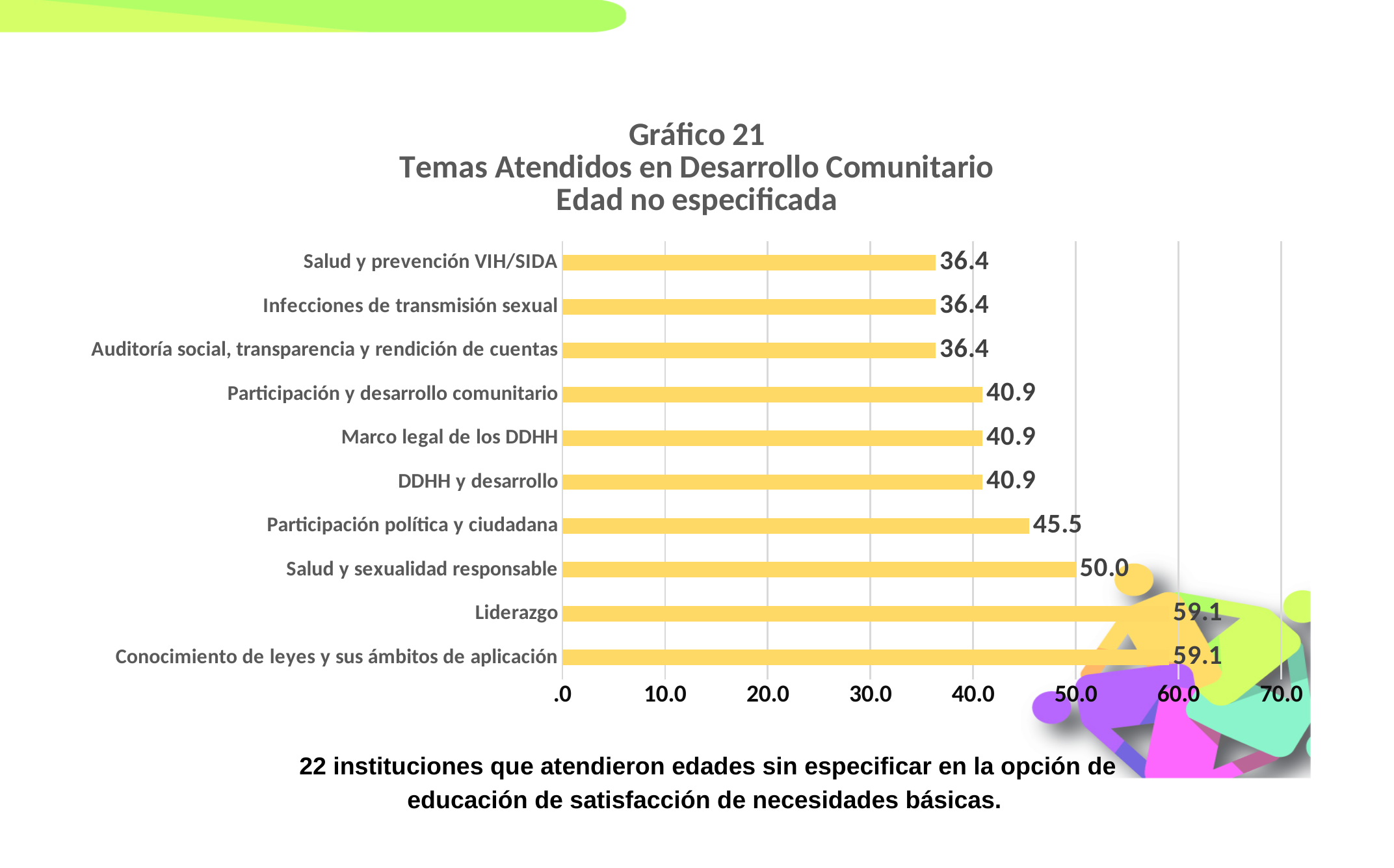
What is the value for Participación política y ciudadana? 45.5 How many categories are shown in the chart? 10 What kind of chart is shown on the slide? bar chart What is the title of the chart? Gráfico 21 Temas Atendidos en Desarrollo Comunitario Edad no especificada What is the value for Salud y prevención VIH/SIDA? 36.4 What is the value for Marco legal de los DDHH? 40.9 Is the value for Salud y sexualidad responsable greater or less than 40.0? greater What is the value for Liderazgo? 59.1 What is the value for Salud y sexualidad responsable? 50.0 Which is larger, the value for Participación y desarrollo comunitario or the value for Auditoría social, transparencia y rendición de cuentas? Participación y desarrollo comunitario What is the difference between the values for Liderazgo and Salud y sexualidad responsable? 9.1 What is the difference between the values for Participación política y ciudadana and Infecciones de transmisión sexual? 9.1